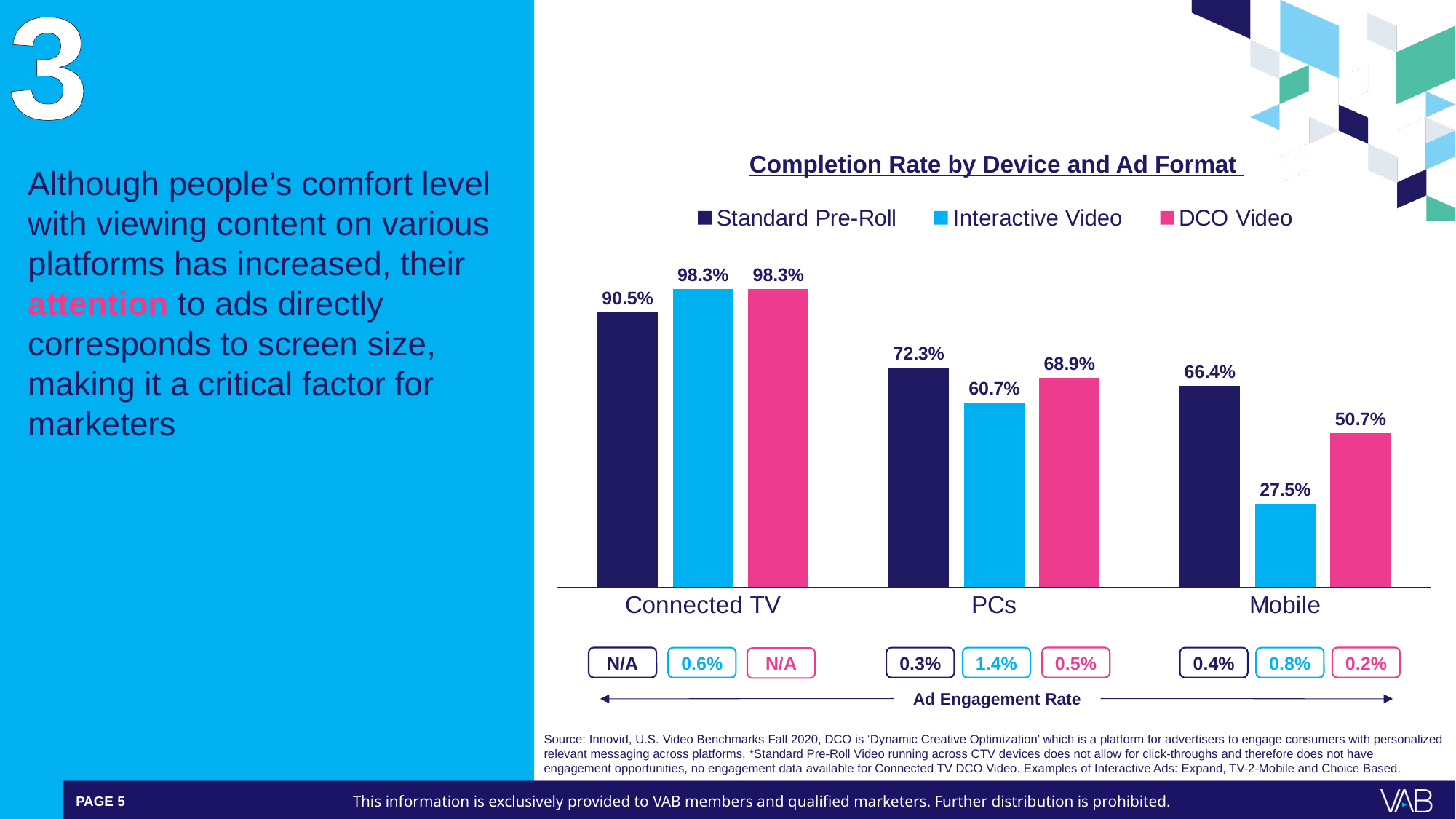
What is the completion rate for Standard Pre-Roll on Connected TV? 90.5% What is the difference between the Standard Pre-Roll and Interactive Video completion rates on Mobile? 38.9% What kind of chart is shown on the slide? Bar chart How many series does the legend list? 3 What is the completion rate for DCO Video on PCs? 68.9% What is the Ad Engagement Rate shown for Interactive Video on PCs? 1.4% How many device categories are shown on the x axis? 3 How does the Standard Pre-Roll completion rate change from Connected TV to PCs to Mobile? It falls Which is larger on PCs: the completion rate for Interactive Video or for DCO Video? DCO Video What is the completion rate for Interactive Video on Mobile? 27.5% Which ad format has the highest completion rate on PCs? Standard Pre-Roll Which device has the lowest completion rate for Interactive Video? Mobile